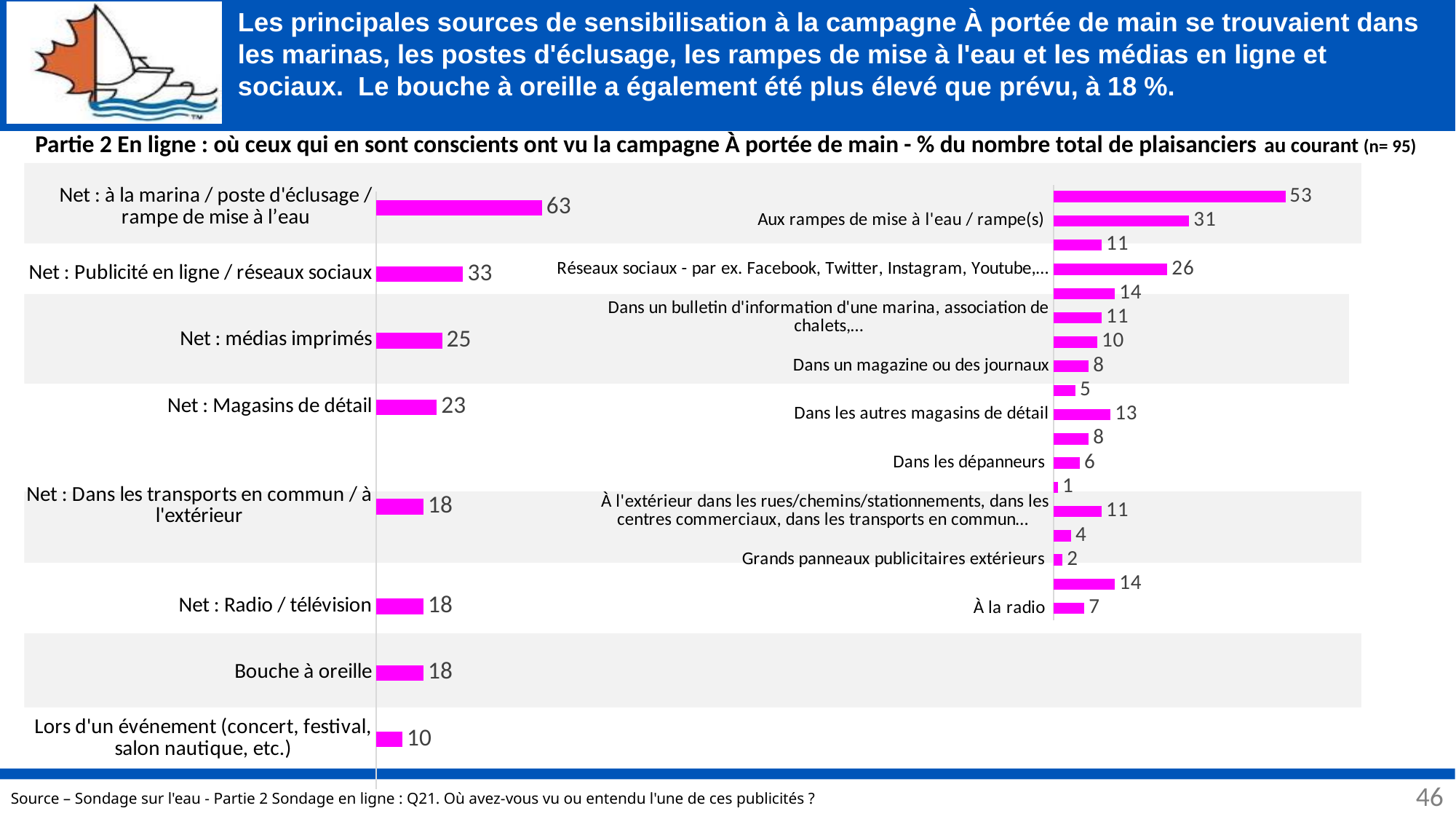
In the right chart, what is the value for "Aux rampes de mise à l'eau / rampe(s)"? 31 In the left chart, how many categories are shown? 8 In the left chart, which category has the highest value? Net : à la marina / poste d'éclusage / rampe de mise à l'eau In the left chart, what is the difference between "Net : médias imprimés" and "Net : Magasins de détail"? 2 In the right chart, what is the value for "Dans les dépanneurs"? 6 In the left chart, what is the value for "Bouche à oreille"? 18 In the right chart, what is the value for "Grands panneaux publicitaires extérieurs"? 2 In the right chart, which is larger: "Dans les autres magasins de détail" or "Dans un magazine ou des journaux"? Dans les autres magasins de détail In the left chart, what is the value for "Net : à la marina / poste d'éclusage / rampe de mise à l'eau"? 63 In the left chart, what is the value for "Net : Publicité en ligne / réseaux sociaux"? 33 In the left chart, which category has the lowest value? Lors d'un événement (concert, festival, salon nautique, etc.) What type of chart is used on this slide? Bar chart